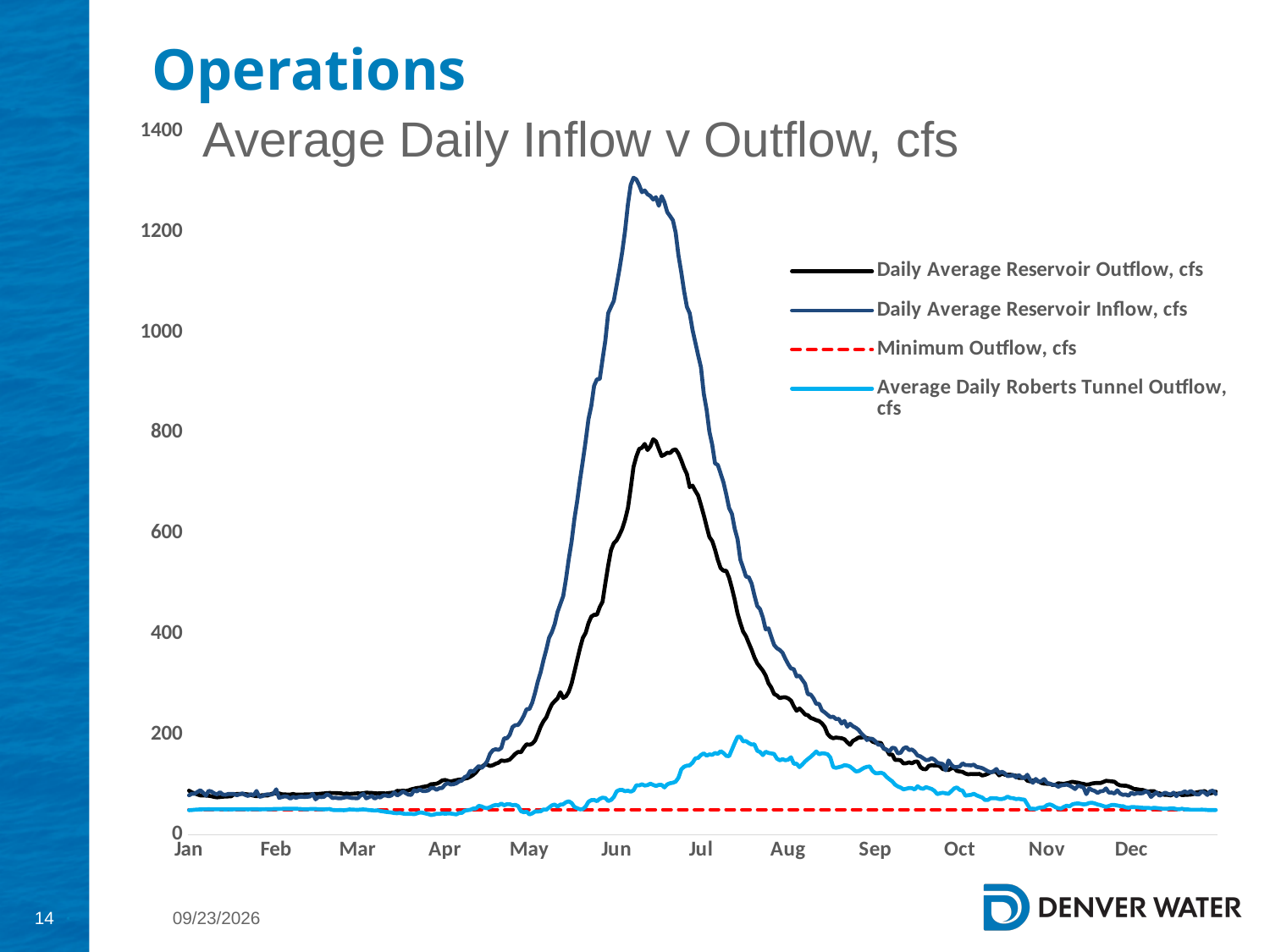
How many series does the legend list? 4 Does the Daily Average Reservoir Inflow rise or fall from Jan to Jun? rise What is the title of the chart? Average Daily Inflow v Outflow, cfs What kind of chart is shown on the slide? line chart In June, which is larger: Daily Average Reservoir Inflow or Daily Average Reservoir Outflow? Daily Average Reservoir Inflow How is the Minimum Outflow series drawn in the chart? red dashed line Which series reaches the highest peak value on the chart? Daily Average Reservoir Inflow, cfs How many months are labelled along the x axis? 12 Is the peak value of Daily Average Reservoir Inflow greater or less than 1200? greater